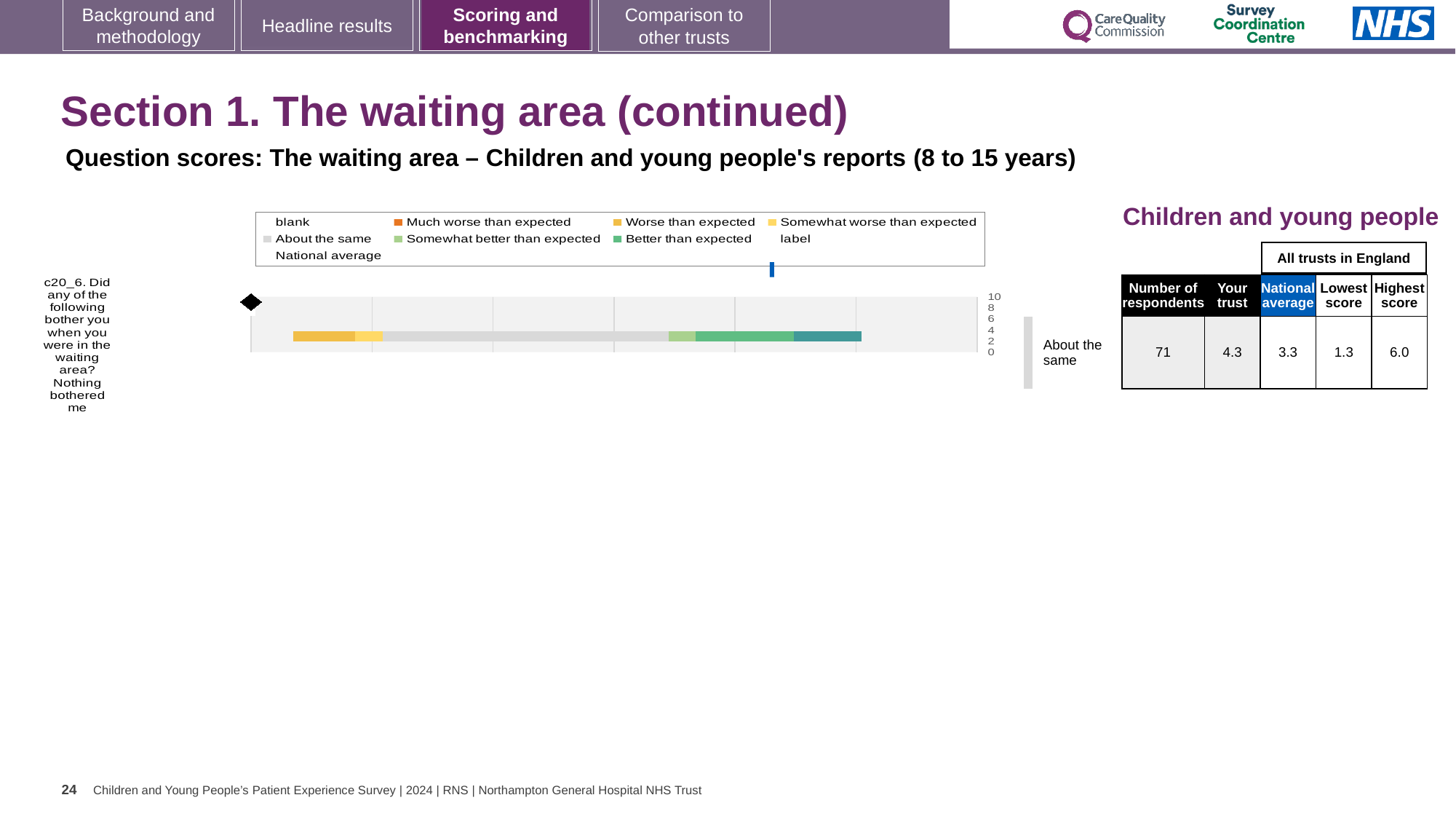
What is the highest tick value shown on the chart's numeric axis? 10 What is the question code of the single category plotted in the bar chart? c20_6 In the table beside the chart, what is the national average score for question c20_6? 3.3 What kind of chart is shown on the slide? bar chart In the table beside the chart, what is the highest score among all trusts in England for question c20_6? 6.0 In the table beside the chart, what is the number of respondents for question c20_6? 71 In the table beside the chart, what is the 'Your trust' score for question c20_6? 4.3 Which legend entry is shown in grey in the bar chart? About the same What is the difference between the highest score (6.0) and the lowest score (1.3) shown in the table for question c20_6? 4.7 In the table beside the chart, what is the lowest score among all trusts in England for question c20_6? 1.3 Which is larger for question c20_6: the 'Your trust' score or the national average? Your trust How many question categories are plotted in the bar chart? 1